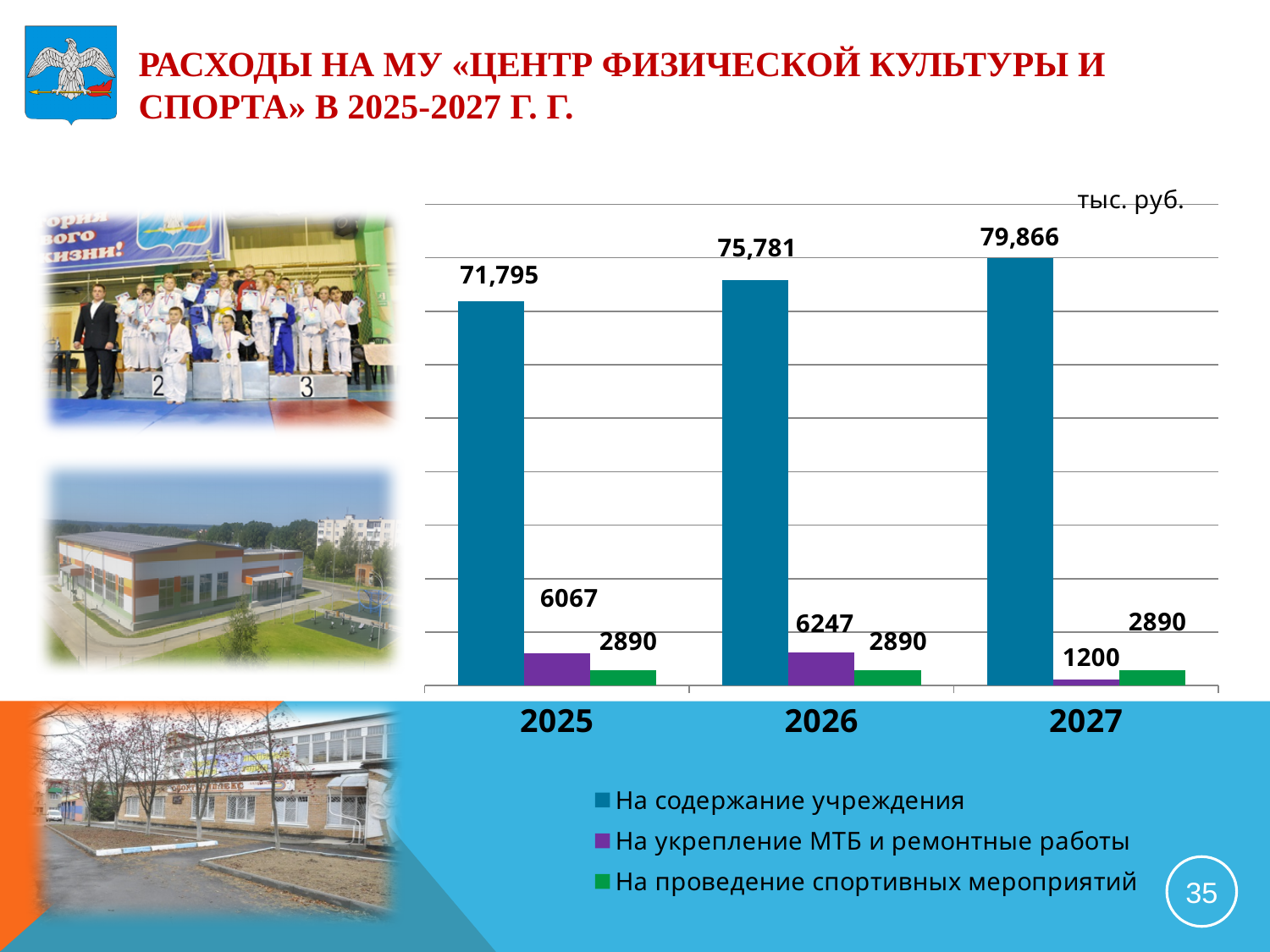
In which year is the value for "На содержание учреждения" the highest? 2027 What is the difference between the "На содержание учреждения" values for 2027 and 2025? 8,071 In which year is the value for "На укрепление МТБ и ремонтные работы" the lowest? 2027 What is the value for "На содержание учреждения" in 2025? 71,795 How many years (categories) are shown on the x axis? 3 Which is larger: "На укрепление МТБ и ремонтные работы" in 2026 or in 2025? 2026 How many series does the legend list? 3 What is the value for "На проведение спортивных мероприятий" in 2026? 2890 Does the value for "На содержание учреждения" rise or fall from 2025 to 2027? Rise What is the value for "На укрепление МТБ и ремонтные работы" in 2027? 1200 What kind of chart is shown on the slide? Bar chart What unit is indicated above the chart? тыс. руб.